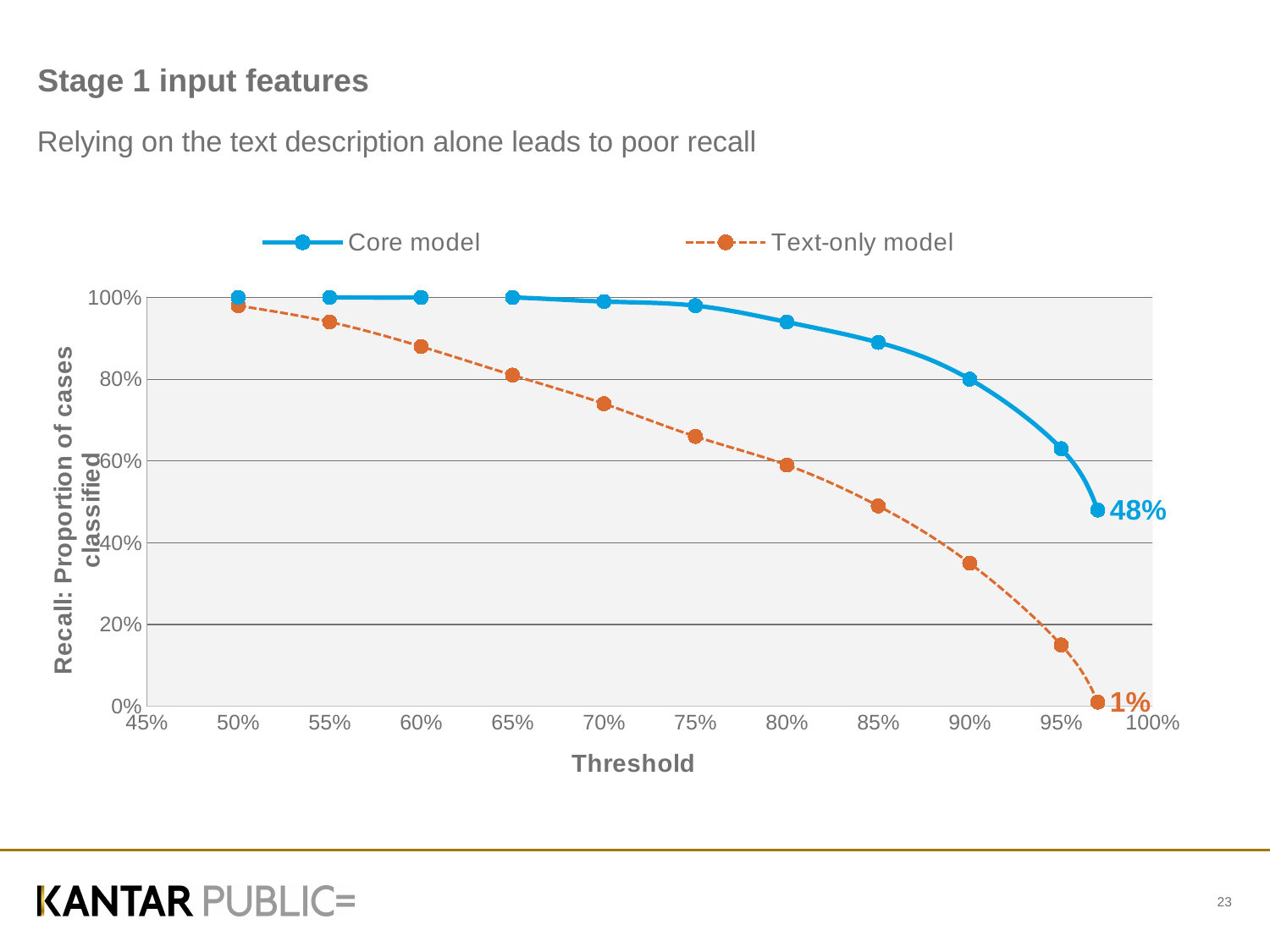
Is the Core model value at an 85% threshold greater or less than 80%? greater How many series does the legend list? 2 Do the recall values rise or fall as the threshold increases along the x axis? Fall At an 80% threshold, which series has the higher recall, the Core model or the Text-only model? Core model What is the difference between the labelled final values of the Core model and the Text-only model? 47 percentage points What is the labelled final value of the Core model line? 48% Is the Text-only model value at a 90% threshold greater or less than 40%? less What is the label of the x axis? Threshold Is the Text-only model value at a 60% threshold greater or less than 80%? greater What is the labelled final value of the Text-only model line? 1% Which series is drawn with a dashed line? Text-only model What kind of chart is shown on the slide? Line chart